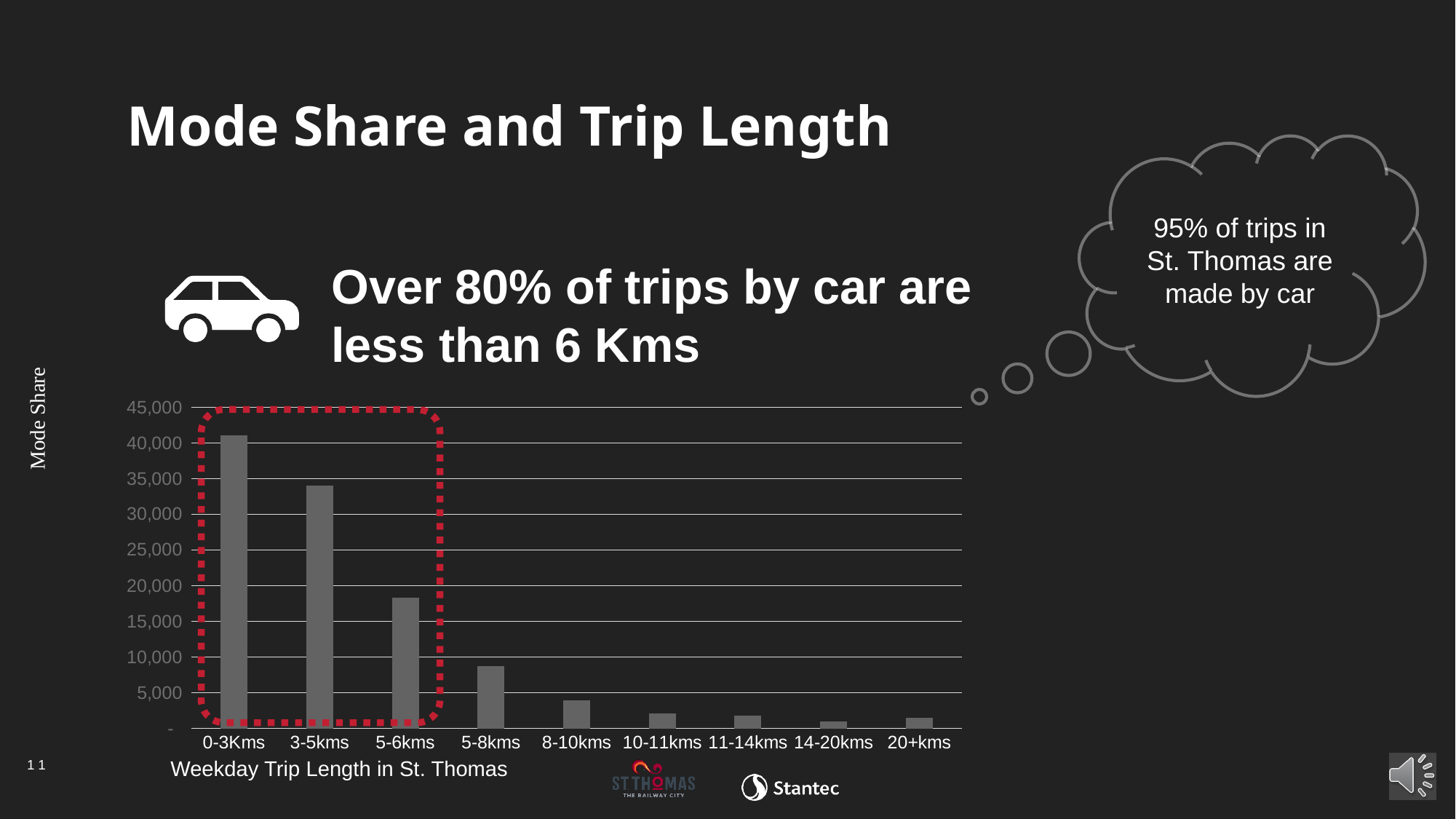
What is the label on the x axis of the chart? Weekday Trip Length in St. Thomas Which is larger, the value for 3-5kms or the value for 5-6kms? 3-5kms Which trip length category has the highest bar? 0-3Kms Which trip length category has the lowest bar? 14-20kms How many trip length categories are shown on the x axis of the chart? 9 Is the value for 5-6kms greater or less than 15,000? greater Is the value for 3-5kms greater or less than 35,000? less Is the value for 5-8kms greater or less than 10,000? less What kind of chart is shown on the slide? bar chart Which is larger, the value for 8-10kms or the value for 10-11kms? 8-10kms Do the bar values generally rise or fall from 0-3Kms to 14-20kms along the x axis? fall